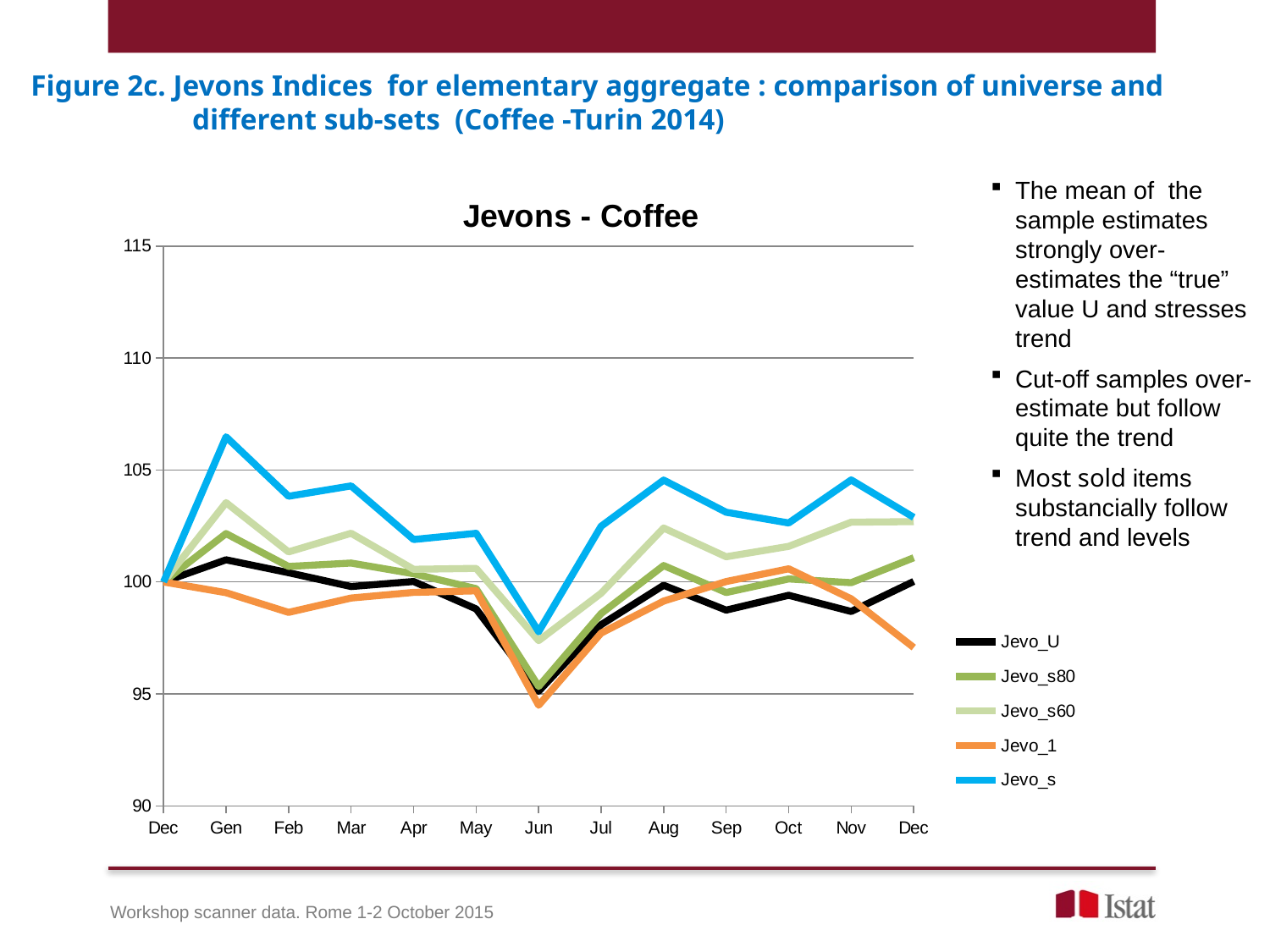
What kind of chart is shown on the slide? line chart Which series has the highest value in Gen? Jevo_s Is the value for Jevo_s in Jun greater or less than 100? less What is the title of the chart? Jevons - Coffee In which month does the Jevo_s series reach its lowest value? Jun Which is larger in Feb, Jevo_U or Jevo_1? Jevo_U Is the value for Jevo_1 at the final Dec greater or less than 100? less Is the value for Jevo_1 in Jun greater or less than 95? less Which colour is used for the Jevo_s series? blue How many points are on the x axis of the chart? 13 How many series does the legend list? 5